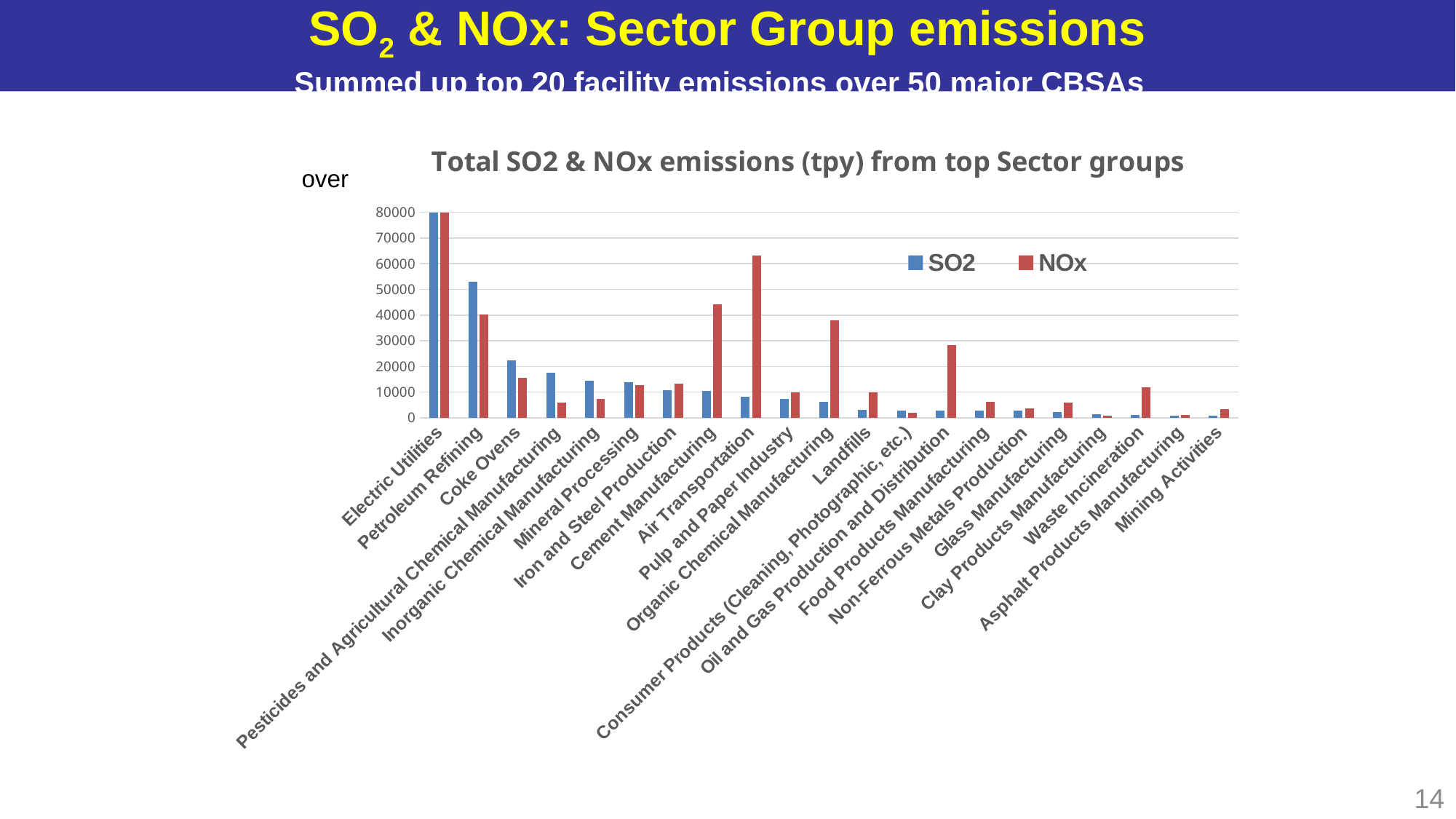
What kind of chart is shown on the slide? bar chart Is the NOx value for Cement Manufacturing greater or less than 40000? greater How many series does the legend list? 2 Is the NOx value for Air Transportation greater or less than 60000? greater Is the SO2 value for Petroleum Refining greater or less than 50000? greater For Air Transportation, which is larger, SO2 or NOx? NOx Which sector group has the highest NOx emissions? Electric Utilities How many sector groups are shown on the x axis? 21 For Coke Ovens, which is larger, SO2 or NOx? SO2 Which sector group has the highest SO2 emissions? Electric Utilities Do the SO2 values generally rise or fall moving from left to right along the x axis? fall